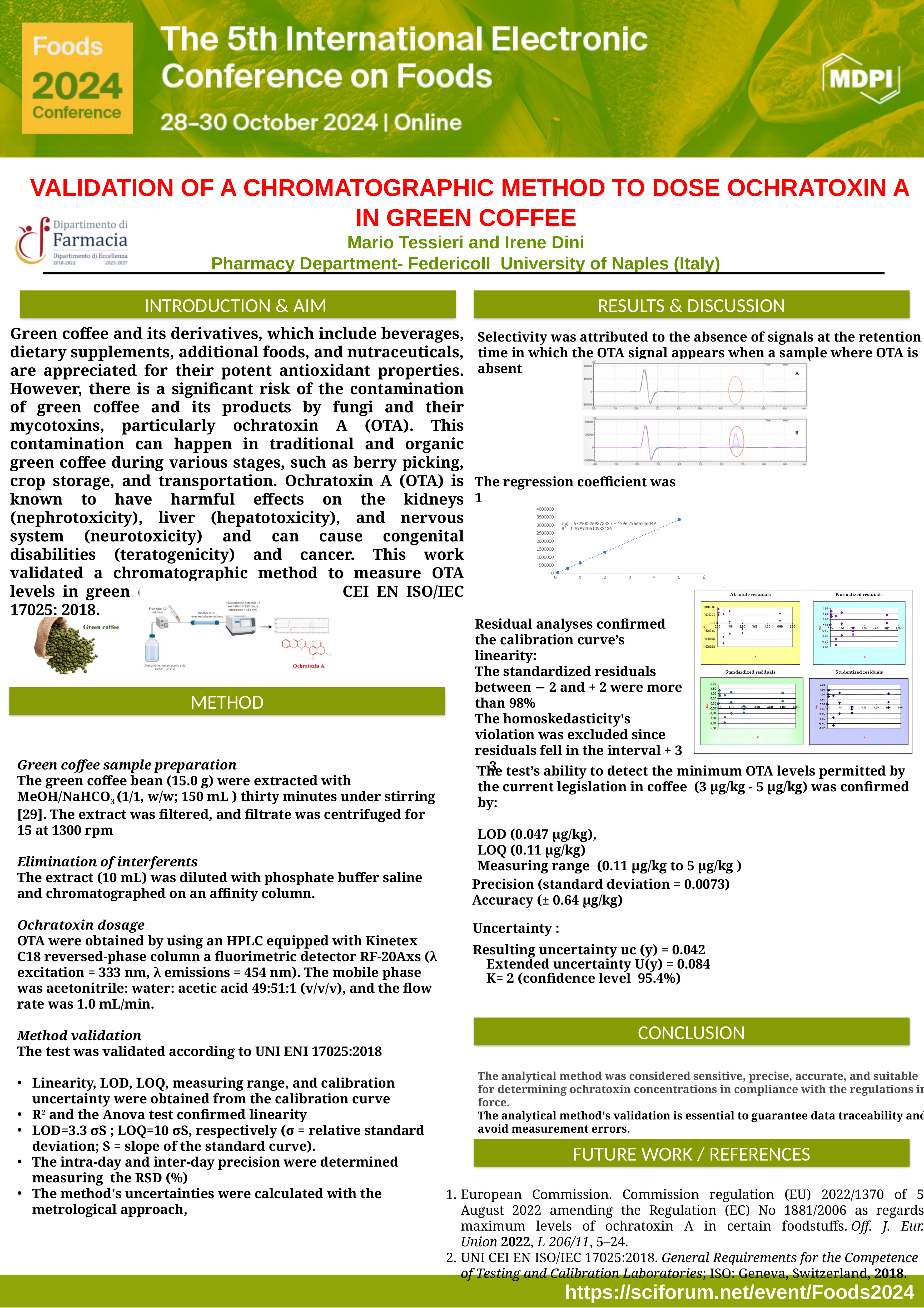
In the calibration curve chart, is the value of the point at x = 1 greater or less than 1000000? less In the calibration curve chart, do the plotted values rise or fall as x increases? rise What is the title of the top-left chart in the group of four residual plots? Absolute residuals In the calibration curve chart, is the value of the point at x = 2 greater or less than 1000000? greater In the calibration curve chart, is the value of the point at x = 5 greater or less than 3000000? greater What kind of chart is the calibration curve plot below the text 'The regression coefficient was 1'? scatter chart with a trendline How many residual plots are shown in the group of four small charts on the right side of the poster? 4 What is the highest tick value shown on the y axis of the calibration curve chart? 4000000